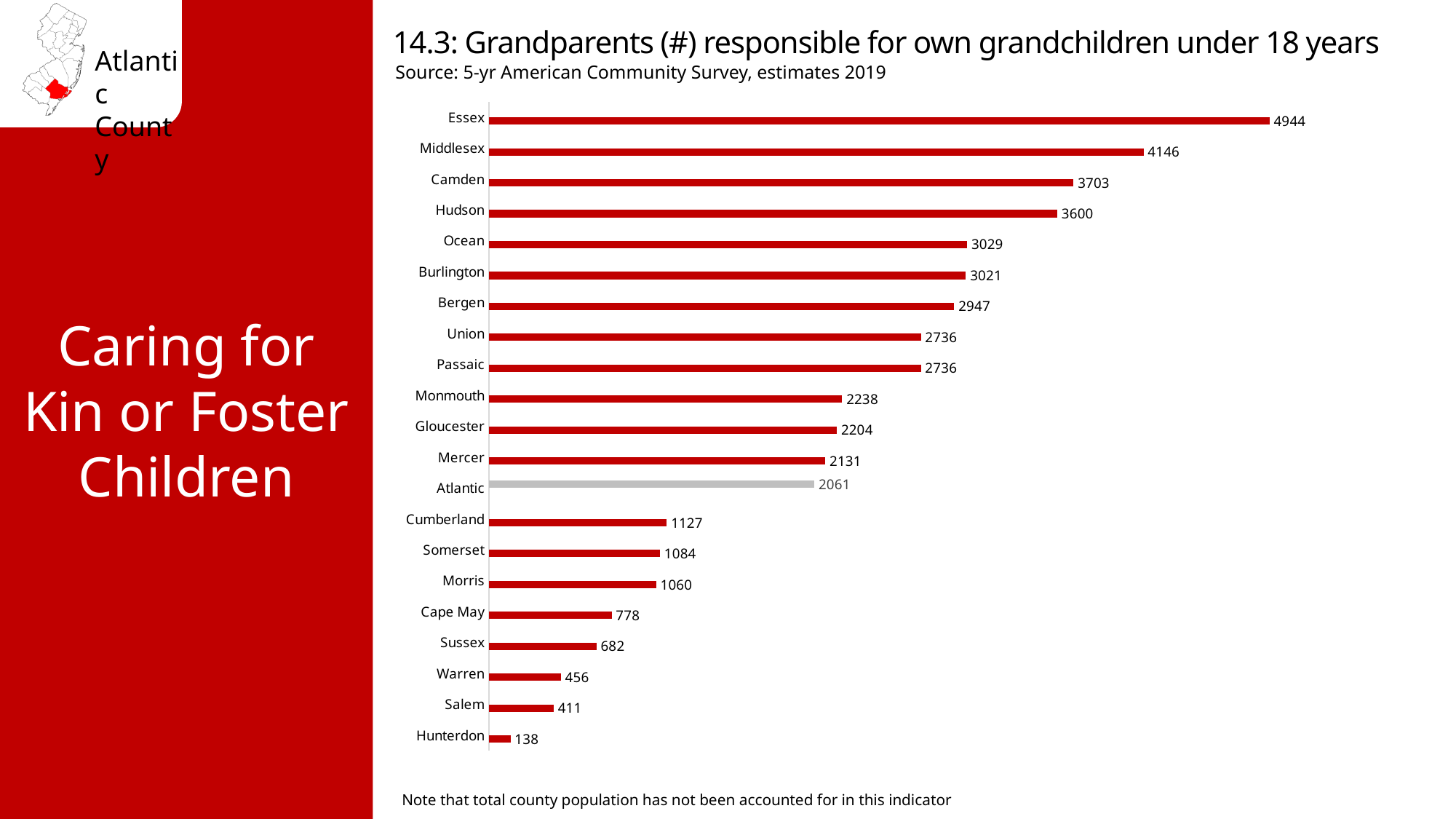
What is the value shown for Camden? 3703 How many counties are shown on the chart? 21 Which has a larger value, Hudson or Ocean? Hudson What is the difference between the values for Mercer and Atlantic? 70 Which county has the highest number of grandparents responsible for own grandchildren? Essex What is the value shown for Hunterdon? 138 What kind of chart is shown on the slide? Bar chart Which county has the lowest value on the chart? Hunterdon Which county's bar is shown in grey rather than red? Atlantic Which has a larger value, Cumberland or Somerset? Cumberland What is the number of grandparents responsible for own grandchildren in Atlantic County? 2061 What is the difference between the values for Essex and Middlesex? 798